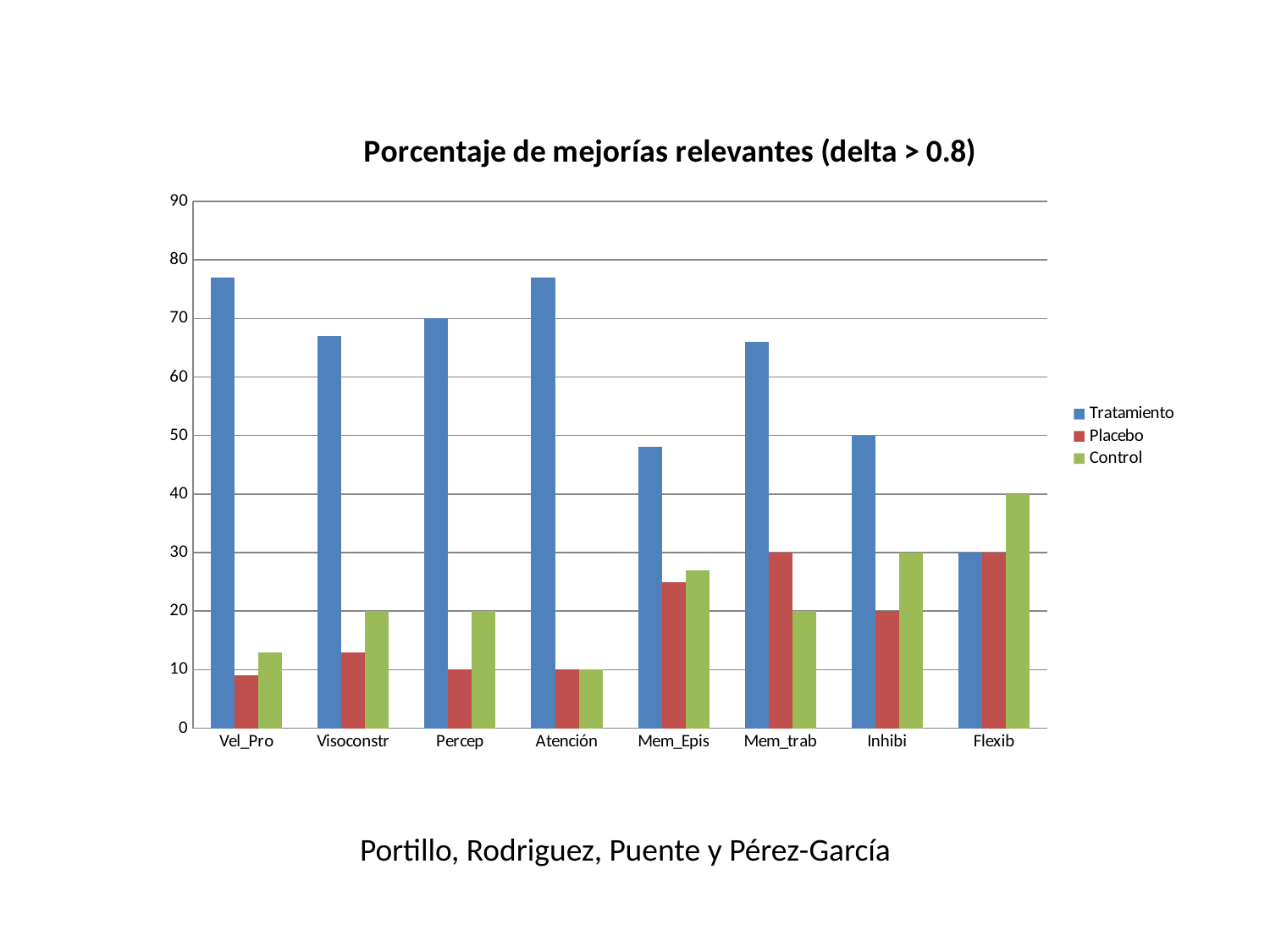
What kind of chart is shown on the slide? bar chart What is the title of the chart? Porcentaje de mejorías relevantes (delta > 0.8) How many series does the legend list? 3 Is the Tratamiento value for Vel_Pro greater or less than 70? greater How many categories are shown on the x axis? 8 Which has the larger Tratamiento value, Mem_trab or Inhibi? Mem_trab What is the Tratamiento value for Inhibi? 50 Which category has the lowest Tratamiento value? Flexib Which category has the highest Control value? Flexib Is the Tratamiento value for Mem_Epis greater or less than 50? less What is the Control value for Percep? 20 What is the Control value for Flexib? 40